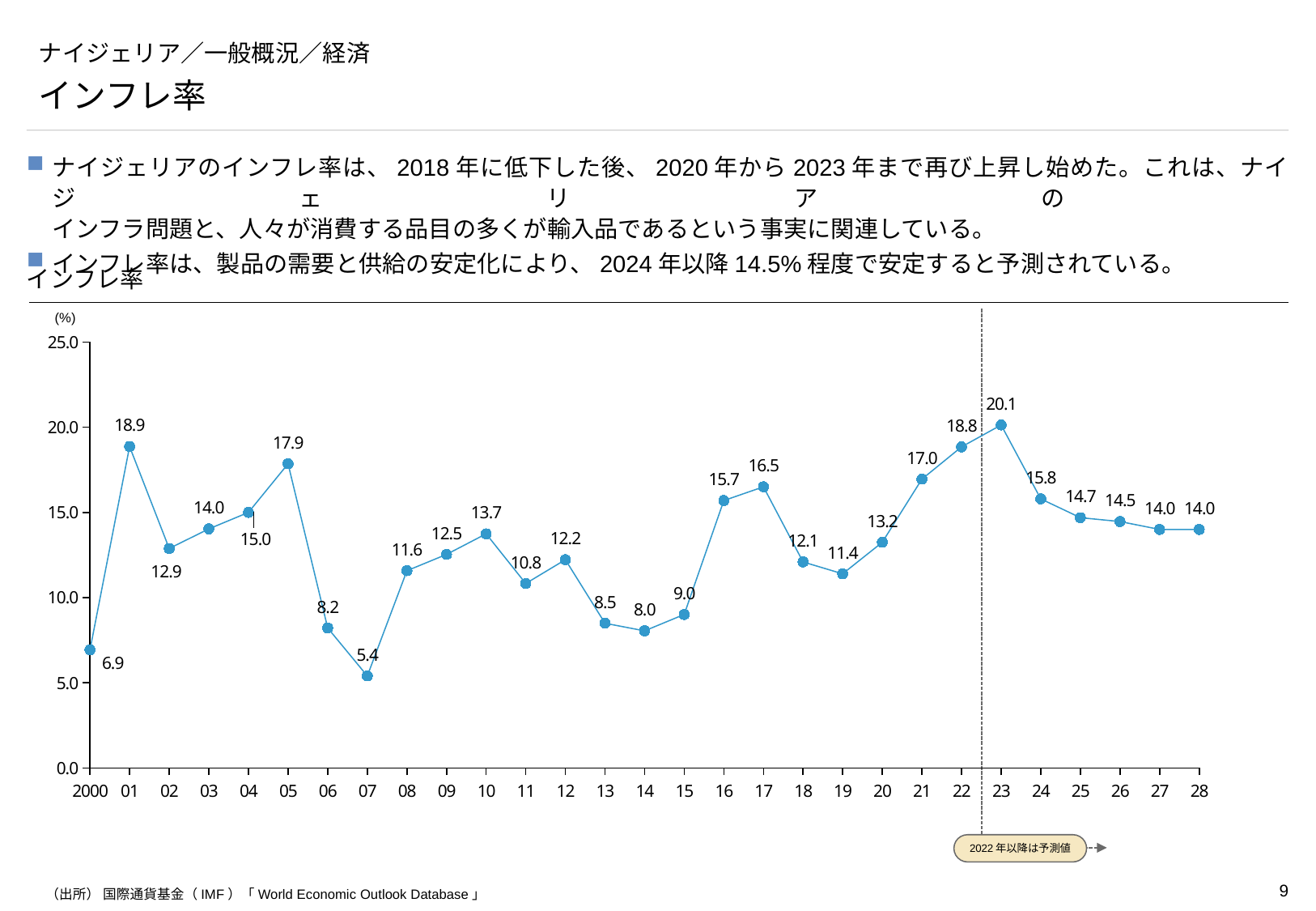
Which year has the lowest inflation rate on the chart? 2007 How many data points are plotted on the chart? 29 Which year has the highest inflation rate on the chart? 2023 What is the inflation rate shown for 2016? 15.7 Do the values rise or fall from 2023 to 2028? Fall What is the difference between the inflation rate in 2023 and in 2024? 4.3 What is the inflation rate shown for 2007? 5.4 What is the inflation rate shown for 2023? 20.1 What is the inflation rate shown for 2001? 18.9 Is the value for 2022 greater or less than 15.0? greater What kind of chart is shown on the slide? Line chart Which is larger, the inflation rate in 2005 or in 2017? 2005